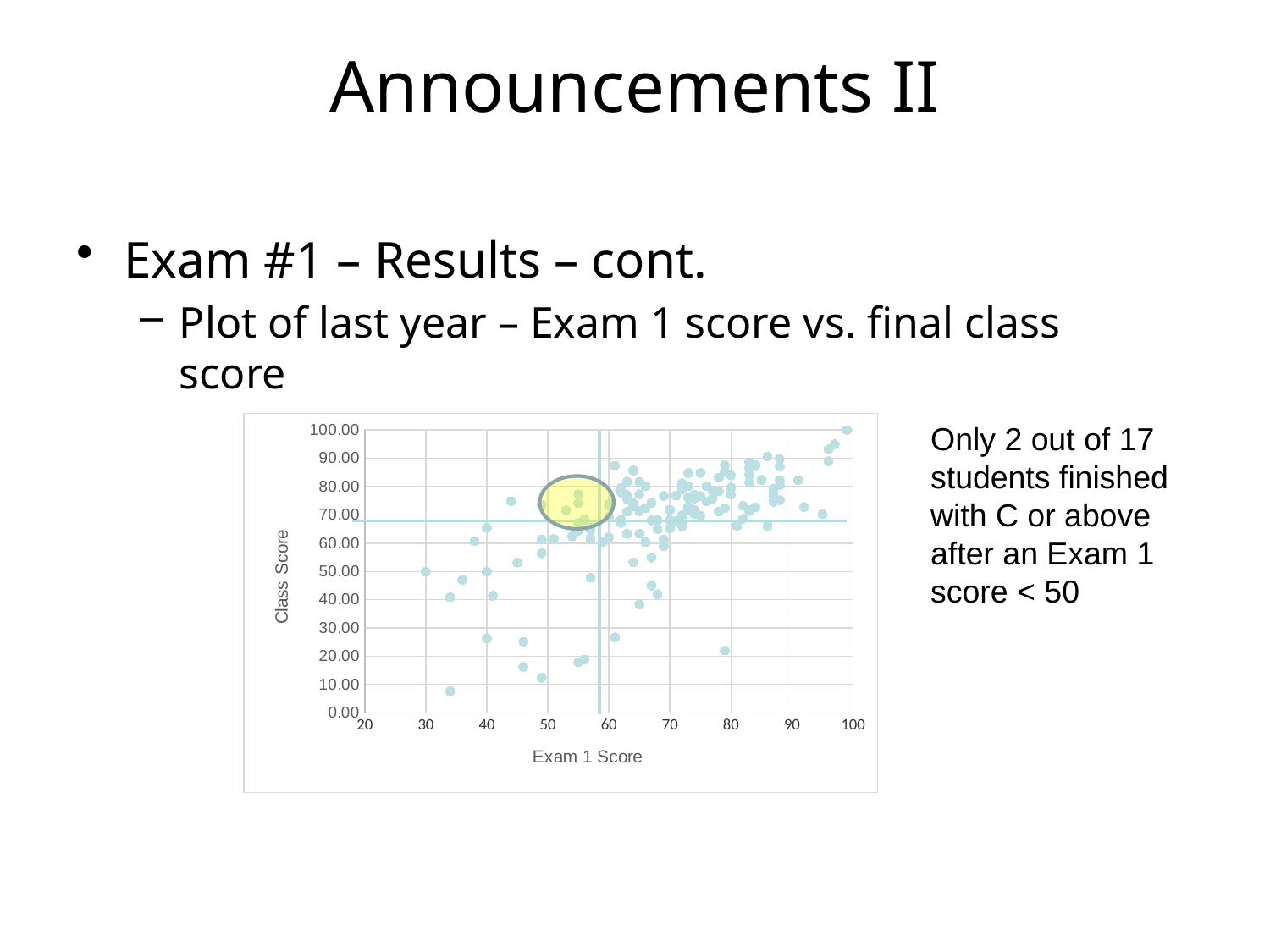
Is the Exam 1 Score of the leftmost point on the chart greater or less than 40? less What is the label of the vertical axis of the chart? Class Score Do the Class Score values generally rise or fall as the Exam 1 Score increases along the x axis? rise Are most of the points on the chart located at Exam 1 Scores greater or less than 50? greater Is the Class Score of the highest point on the chart greater or less than 90.00? greater What kind of chart is shown on the slide? scatter plot What is the label of the horizontal axis of the chart? Exam 1 Score